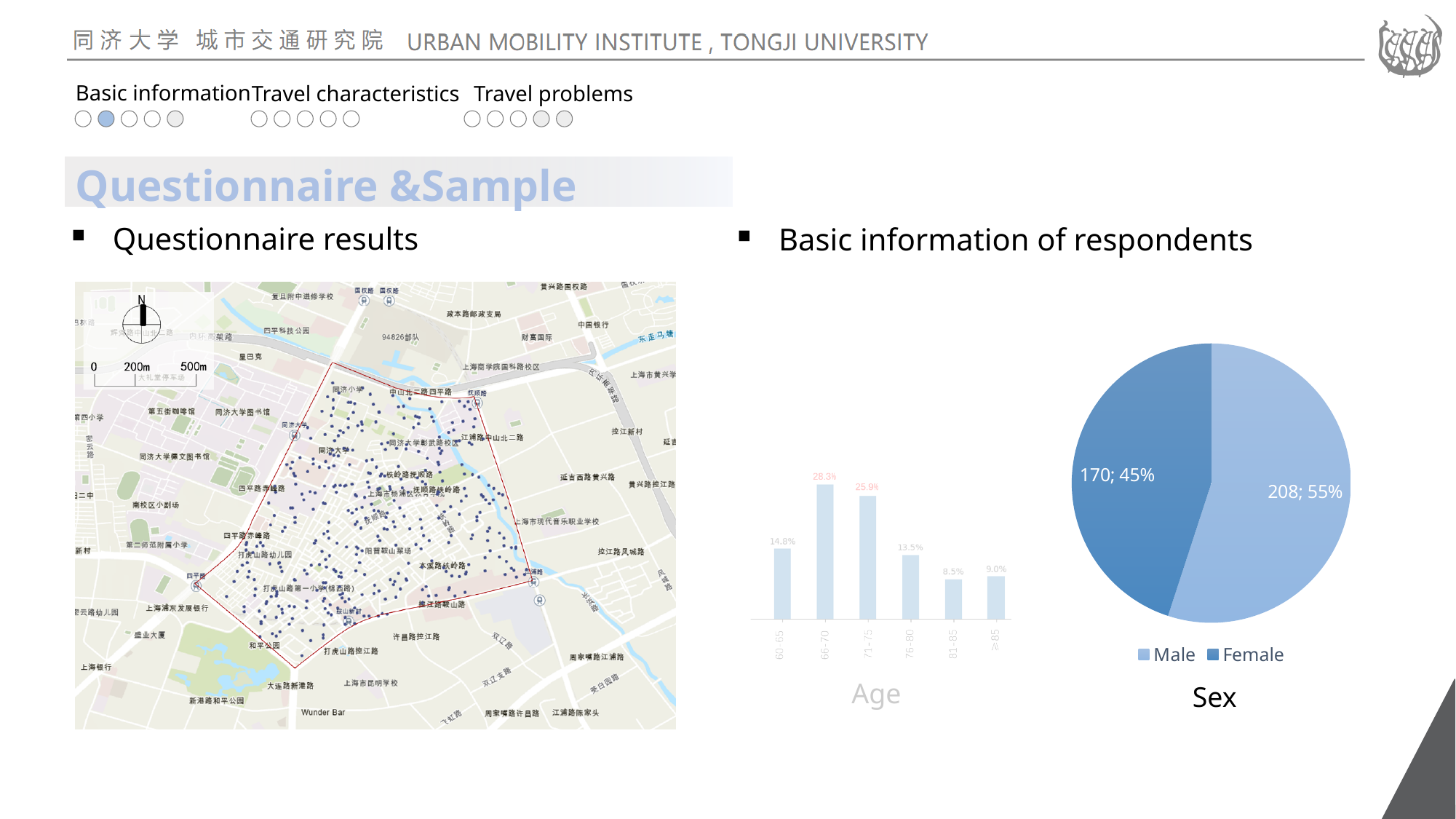
How many entries does the legend of the Sex chart list? 2 How many age groups are shown in the Age chart? 6 In the Age chart, what percentage of respondents are aged 81-85? 8.5% In the Sex chart, what share of respondents are female? 45% In the Age chart, which age group has the lowest percentage? 81-85 In the Age chart, which age group has the highest percentage? 66-70 In the Sex chart, what is the difference between the number of male and female respondents? 38 In the Age chart, what percentage of respondents are aged 66-70? 28.3% In the Sex chart, how many respondents are male? 208 In the Age chart, which group has a larger share: 60-65 or 76-80? 60-65 What type of chart is the Age chart? bar chart In the Age chart, what is the difference in percentage points between the 66-70 and 71-75 groups? 2.4